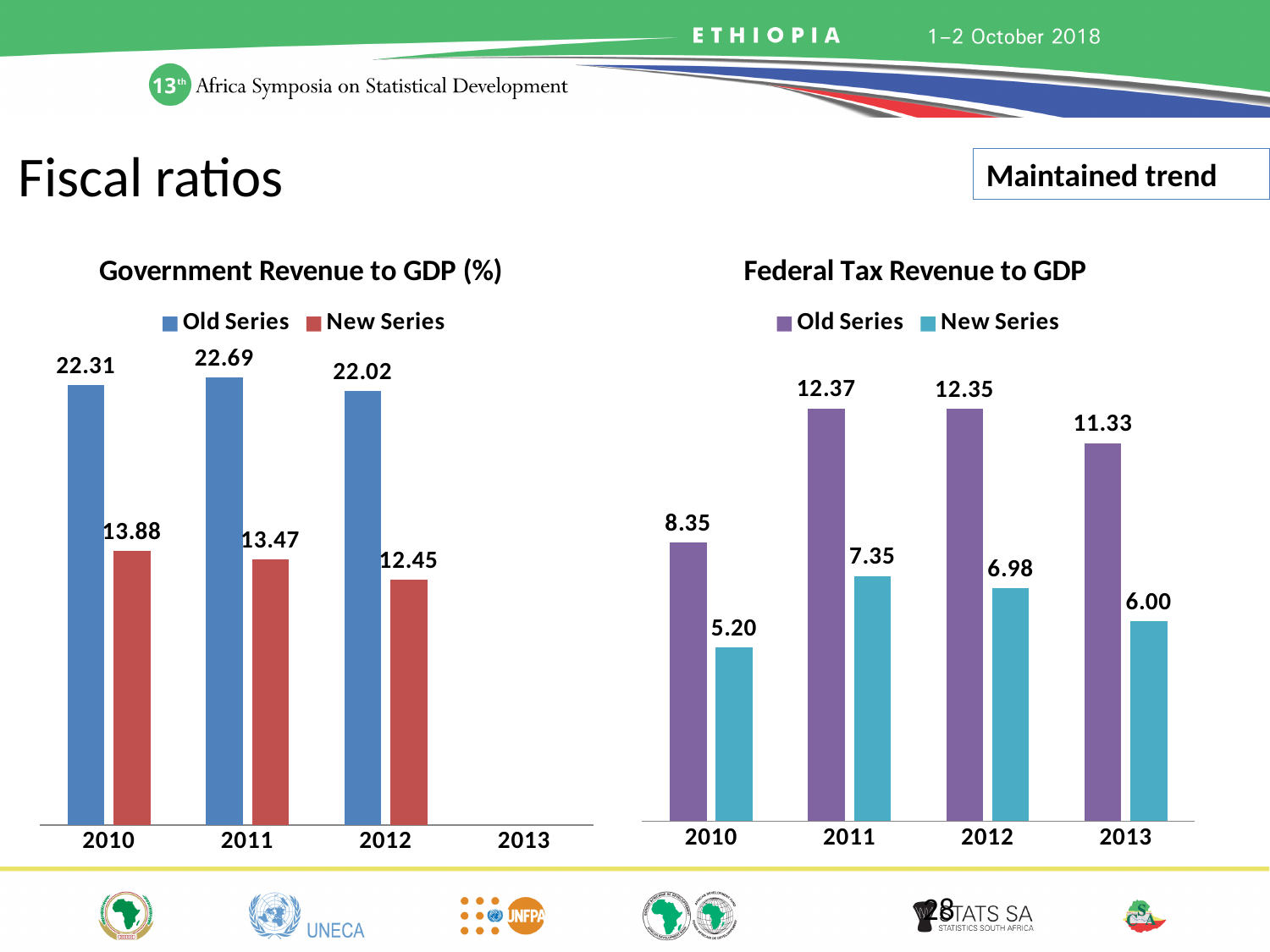
In the 'Federal Tax Revenue to GDP' chart, which year has the lowest New Series value? 2010 In the 'Federal Tax Revenue to GDP' chart, what is the Old Series value for 2013? 11.33 In the 'Government Revenue to GDP (%)' chart, do the New Series values rise or fall from 2010 to 2012? fall In the 'Federal Tax Revenue to GDP' chart, what is the New Series value for 2010? 5.20 In the 'Government Revenue to GDP (%)' chart, what is the Old Series value for 2011? 22.69 In the 'Government Revenue to GDP (%)' chart, what is the New Series value for 2012? 12.45 What kind of chart is the 'Federal Tax Revenue to GDP' chart? bar chart In the 'Government Revenue to GDP (%)' chart, how many series does the legend list? 2 In the 'Government Revenue to GDP (%)' chart, which year has the highest Old Series value? 2011 In the 'Federal Tax Revenue to GDP' chart, which is larger: the New Series value for 2011 or for 2012? 2011 In the 'Federal Tax Revenue to GDP' chart, how many years are shown on the x axis? 4 In the 'Government Revenue to GDP (%)' chart, what is the difference between the Old Series and New Series values for 2010? 8.43